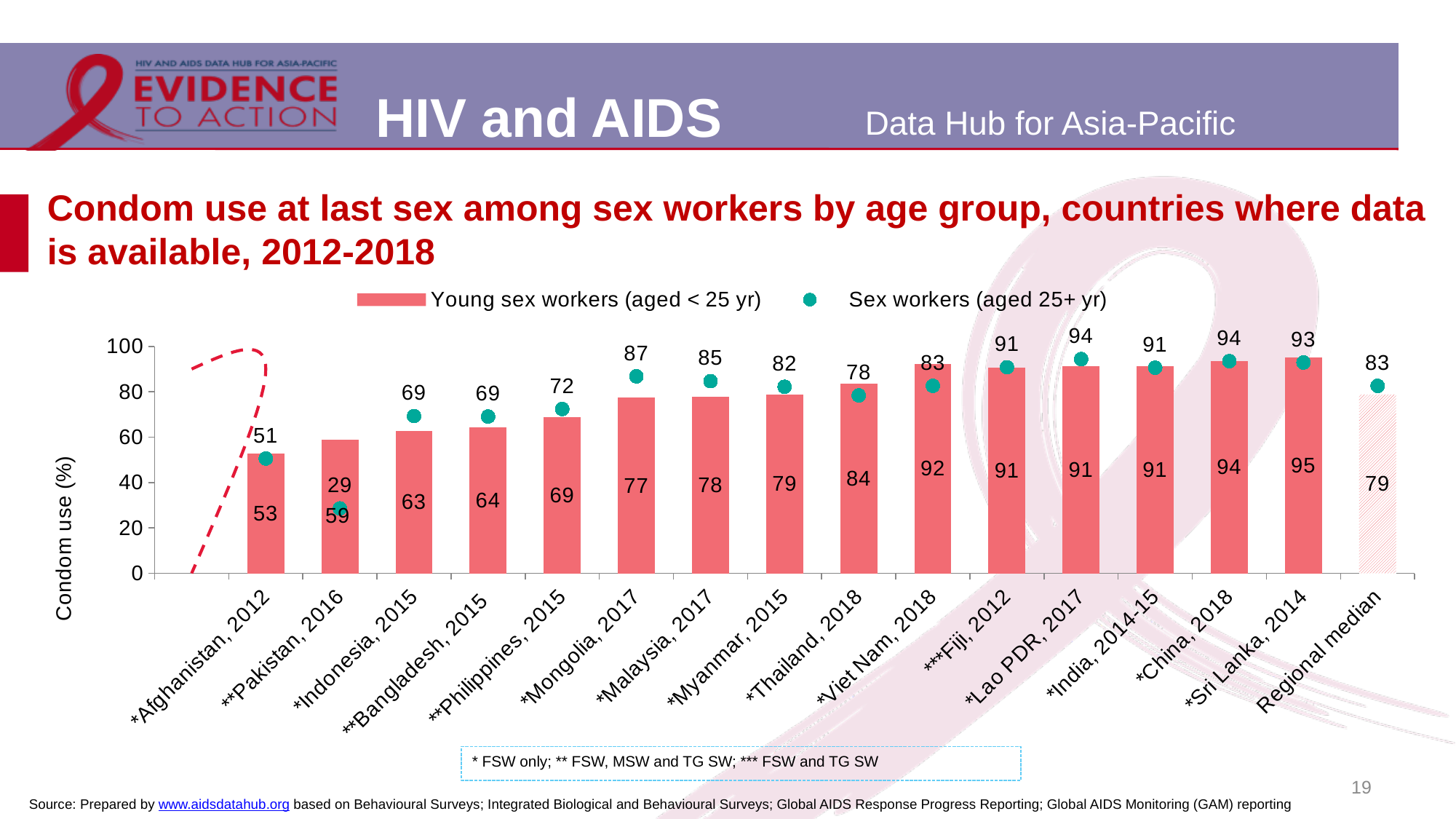
How many series does the legend list? 2 What is the value for sex workers (aged 25+ yr) in **Pakistan, 2016? 29 How many categories are shown on the x axis of the chart? 16 In *Thailand, 2018, which group has the larger value: young sex workers (aged < 25 yr) or sex workers (aged 25+ yr)? Young sex workers (aged < 25 yr) What is the label of the y axis? Condom use (%) In *Mongolia, 2017, what is the difference between the value for sex workers (aged 25+ yr) and young sex workers (aged < 25 yr)? 10 In **Pakistan, 2016, how much higher is the value for young sex workers (aged < 25 yr) than for sex workers (aged 25+ yr)? 30 Which country has the highest value for young sex workers (aged < 25 yr)? *Sri Lanka, 2014 What is the regional median value for young sex workers (aged < 25 yr)? 79 What kind of chart is used to show the young sex workers (aged < 25 yr) series? Bar chart What is the value for young sex workers (aged < 25 yr) in *Thailand, 2018? 84 Which country has the lowest value for sex workers (aged 25+ yr)? **Pakistan, 2016